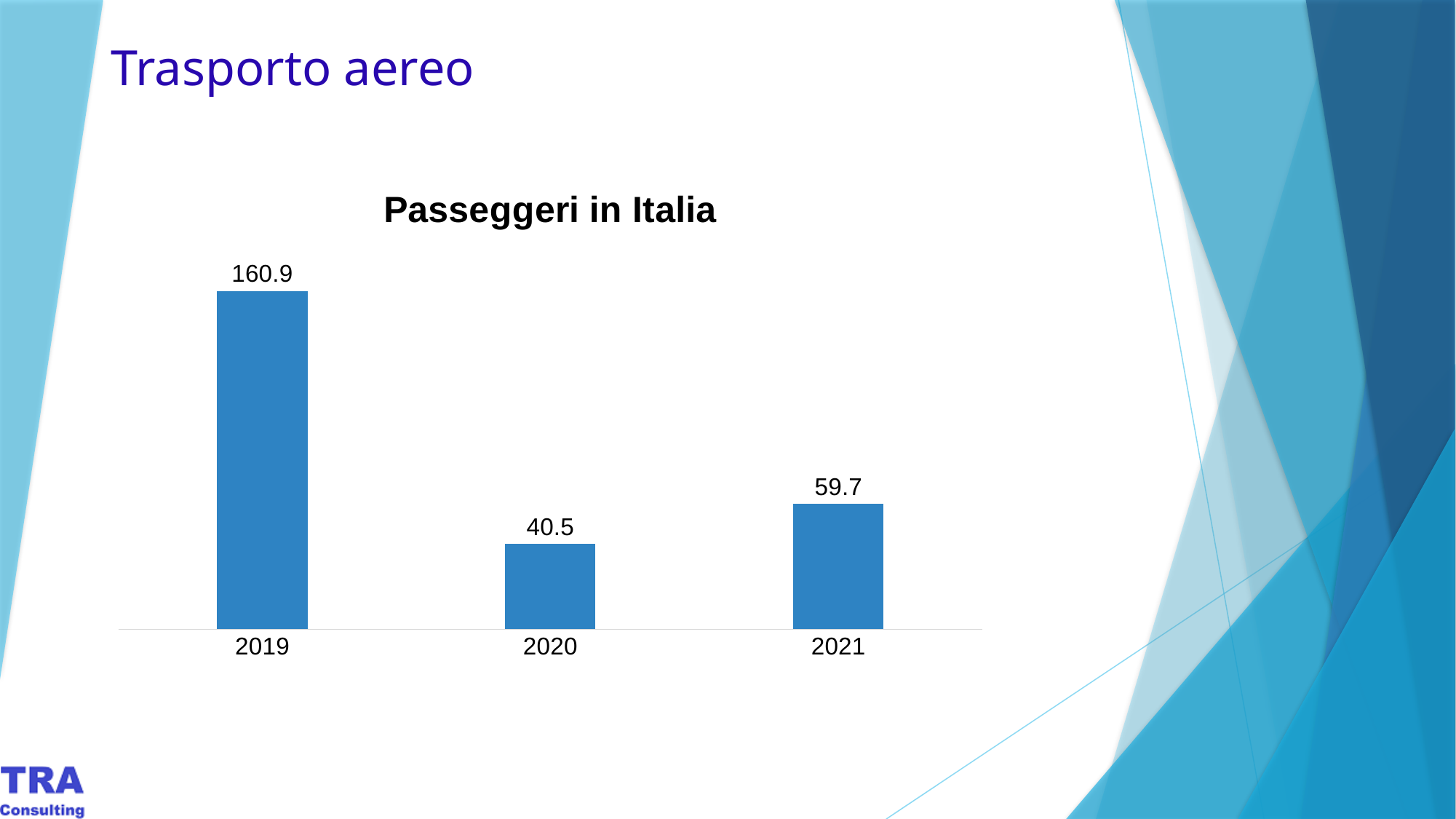
What is the value for 2019 in the Passeggeri in Italia chart? 160.9 What is the title of the chart on the slide? Passeggeri in Italia How many years are shown in the Passeggeri in Italia chart? 3 Which year has the lowest value in the Passeggeri in Italia chart? 2020 Does the value fall or rise from 2019 to 2020 in the Passeggeri in Italia chart? fall Which year has the highest value in the Passeggeri in Italia chart? 2019 What kind of chart is the Passeggeri in Italia chart? bar chart What is the difference between the 2019 and 2020 values in the Passeggeri in Italia chart? 120.4 Which is larger in the Passeggeri in Italia chart, the value for 2020 or the value for 2021? 2021 What is the value for 2020 in the Passeggeri in Italia chart? 40.5 What is the difference between the 2021 and 2020 values in the Passeggeri in Italia chart? 19.2 What is the value for 2021 in the Passeggeri in Italia chart? 59.7